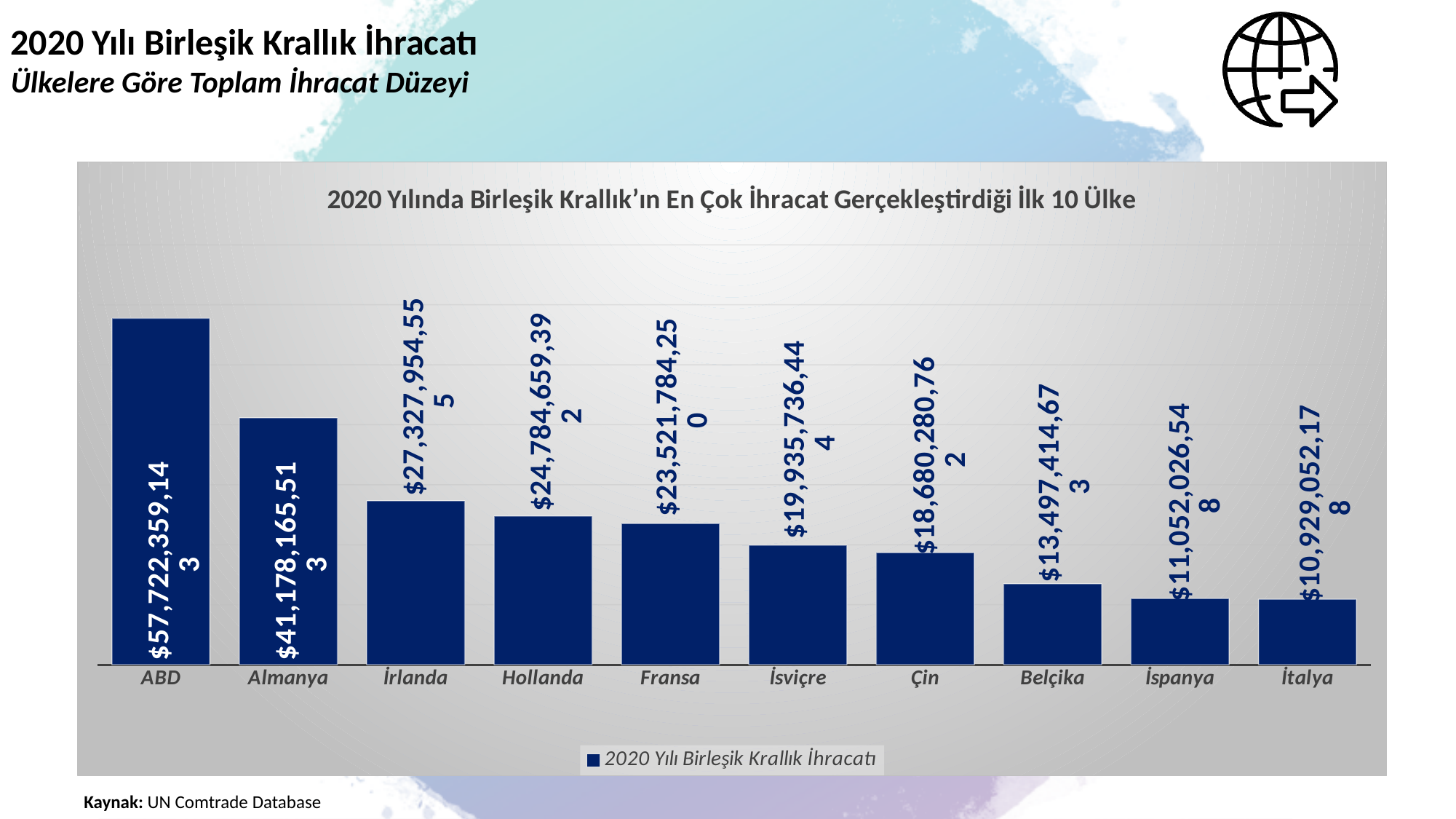
What kind of chart is shown? Bar chart What is the export value for Fransa? $23,521,784,250 What is the difference between the export values for ABD and Almanya? $16,544,193,630 What is the export value for Çin? $18,680,280,762 Which has a larger export value, Hollanda or İsviçre? Hollanda Which country has the highest export value? ABD What is the export value for ABD? $57,722,359,143 What is the export value for Belçika? $13,497,414,673 Do the values rise or fall from left to right along the x axis? Fall How many countries are shown in the chart? 10 How many series does the legend list? 1 Which country has the lowest export value? İtalya